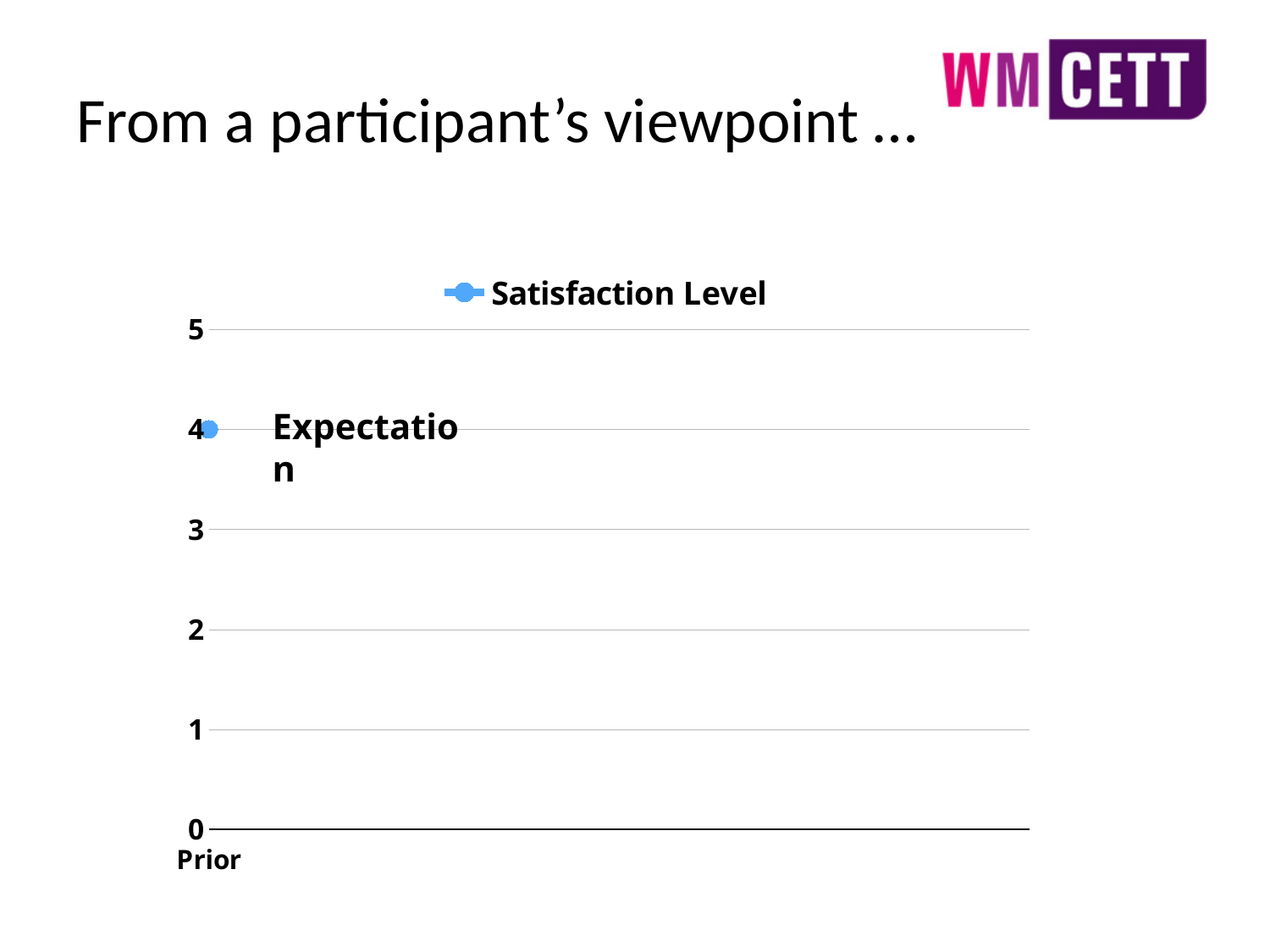
What kind of chart is shown on the slide? line chart How many data points are plotted on the chart? 1 Is the Satisfaction Level value at Prior greater or less than 3? greater What is the Satisfaction Level value at Prior? 4 What is the name of the series shown in the chart legend? Satisfaction Level Is the Satisfaction Level value at Prior greater or less than 5? less How many series does the chart legend list? 1 What category label appears on the x axis of the chart? Prior What is the highest value shown on the chart's y axis? 5